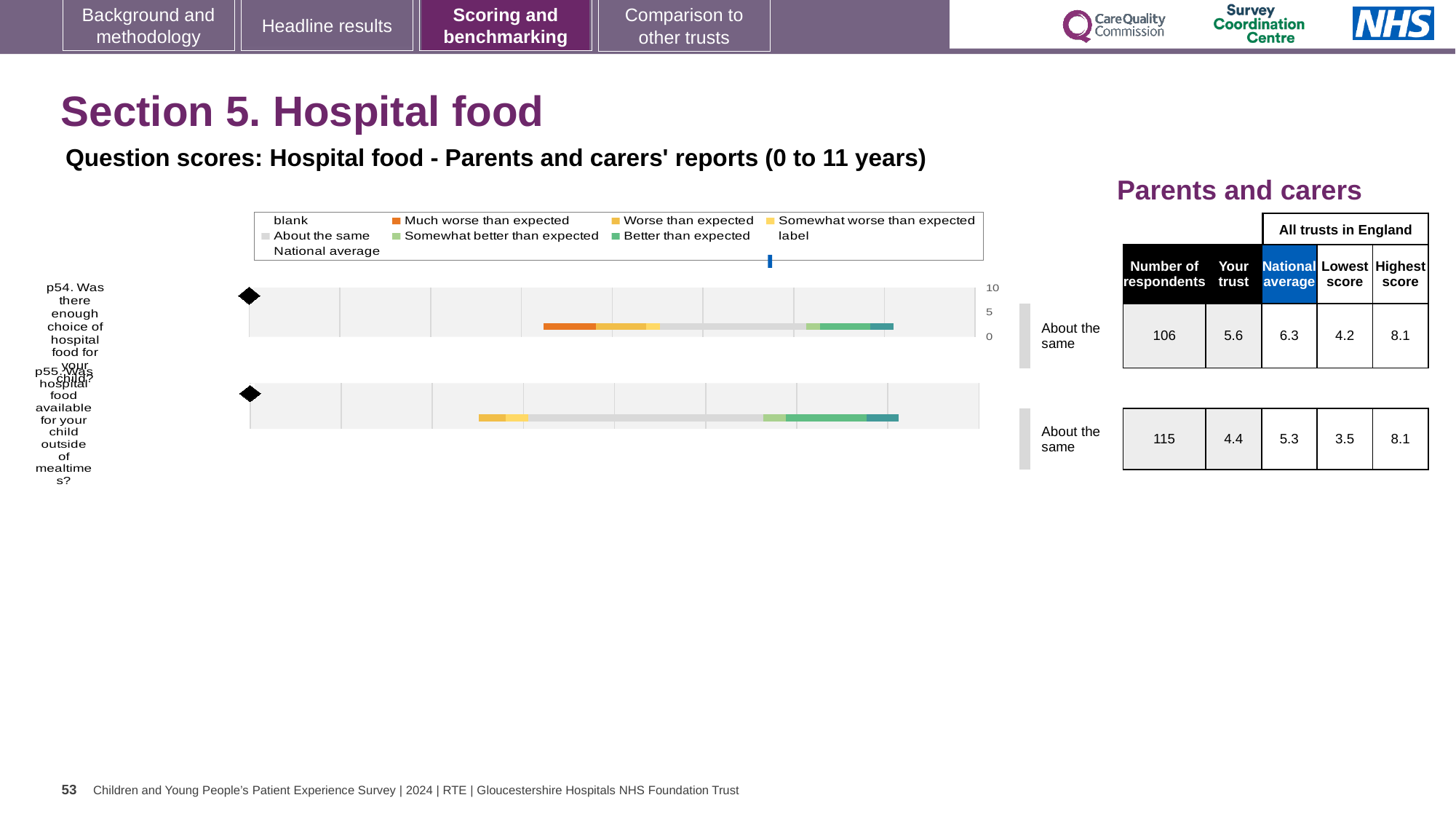
According to the table beside the chart, what is the national average for p55? 5.3 What benchmark category is shown next to the bar for p55? About the same How many questions (categories) are plotted in the chart? 2 What is the highest value shown on the chart's numeric axis? 10 According to the table beside the chart, which question has the higher 'Your trust' score, p54 or p55? p54 According to the table beside the chart, what is the 'Your trust' score for p55? 4.4 What benchmark category is shown next to the bar for p54? About the same According to the table beside the chart, how many respondents answered p55? 115 According to the table beside the chart, what is the difference between the national average and the 'Your trust' score for p54? 0.7 What kind of chart is shown on the slide? bar chart According to the table beside the chart, what is the 'Your trust' score for p54? 5.6 Which colour in the legend represents 'Much worse than expected'? orange